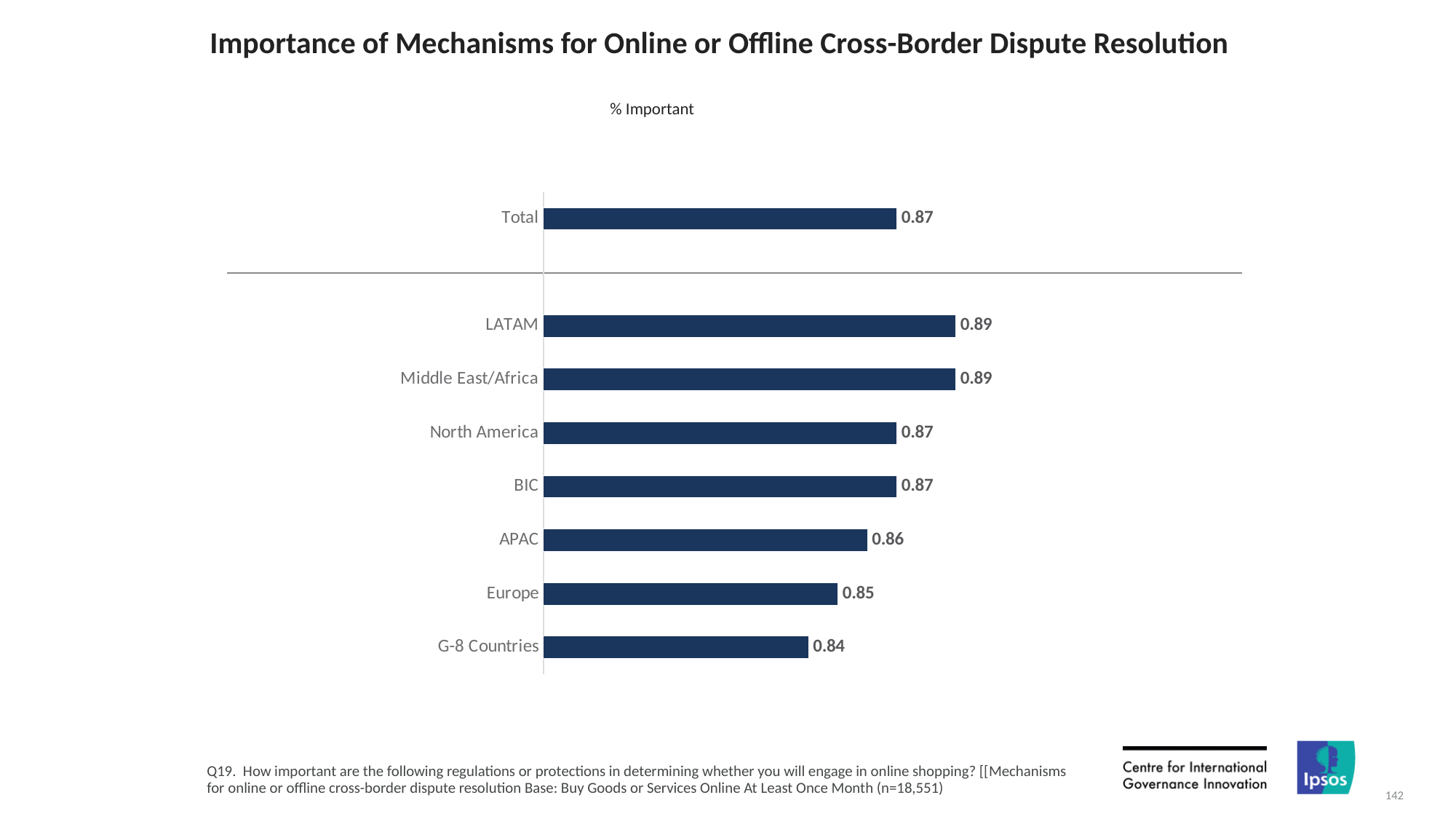
Which category has the lowest value? G-8 Countries What kind of chart is shown on the slide? Bar chart How many categories are shown in the chart? 8 What is the difference between the values for LATAM and G-8 Countries? 0.05 What is the value for Middle East/Africa? 0.89 What is the value for APAC? 0.86 What is the value for Europe? 0.85 What is the title of the chart? Importance of Mechanisms for Online or Offline Cross-Border Dispute Resolution What is the value for G-8 Countries? 0.84 Which is larger, the value for APAC or the value for G-8 Countries? APAC What is the value for Total? 0.87 What is the difference between the values for North America and Europe? 0.02